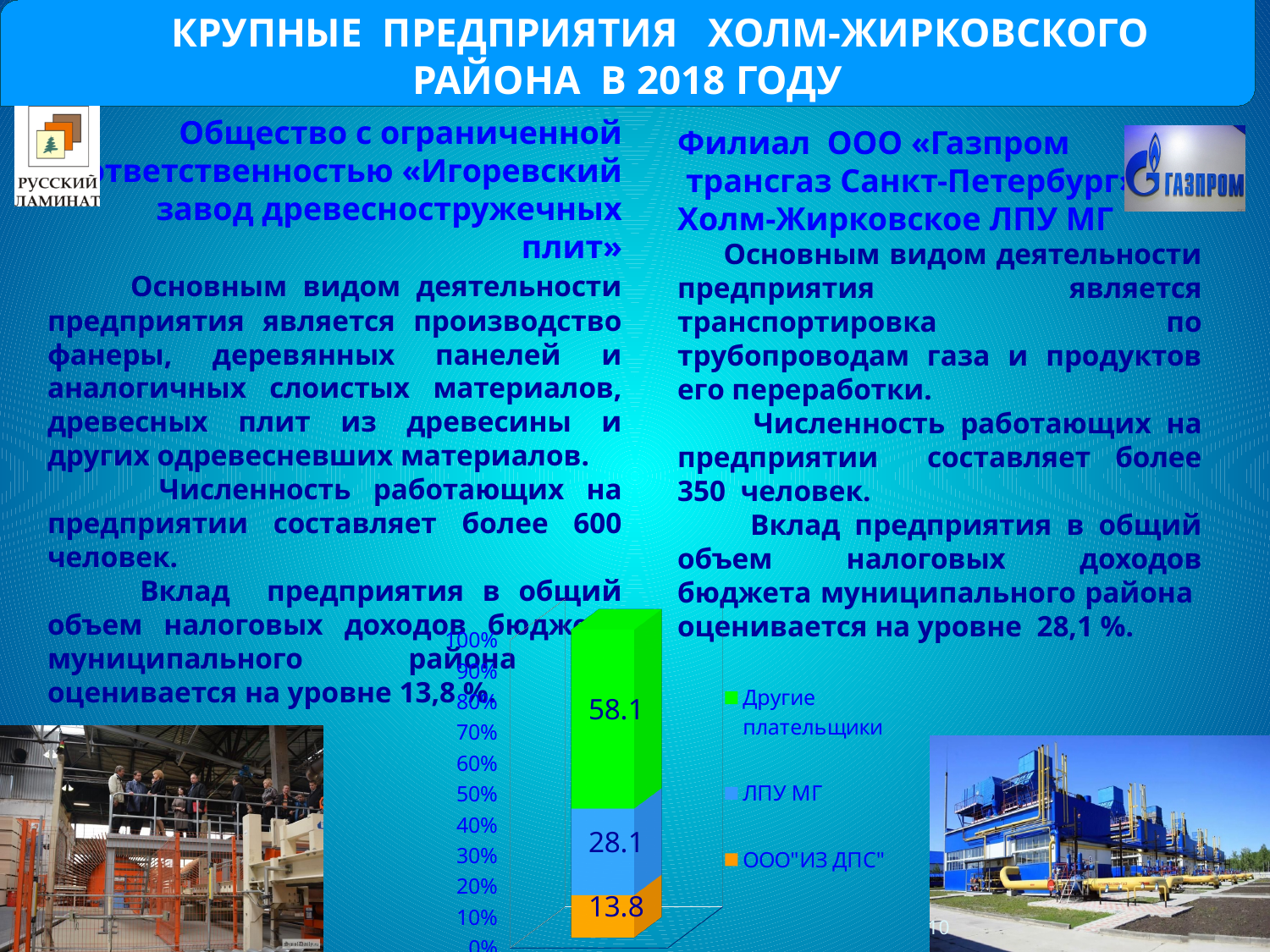
What is the difference between the ЛПУ МГ segment and the ООО"ИЗ ДПС" segment? 14.3 What is the value of the segment for ООО"ИЗ ДПС"? 13.8 How many series does the chart legend list? 3 Which is larger, the segment for ЛПУ МГ or the segment for ООО"ИЗ ДПС"? ЛПУ МГ What is the value of the segment for Другие плательщики? 58.1 Which legend entry has the smallest segment in the bar? ООО"ИЗ ДПС" What is the difference between the Другие плательщики segment and the ЛПУ МГ segment? 30 What colour is the segment for Другие плательщики? green What kind of chart is shown on the slide? stacked bar chart What is the total of the three segments in the stacked bar? 100 What is the value of the segment for ЛПУ МГ? 28.1 Which legend entry has the largest segment in the bar? Другие плательщики